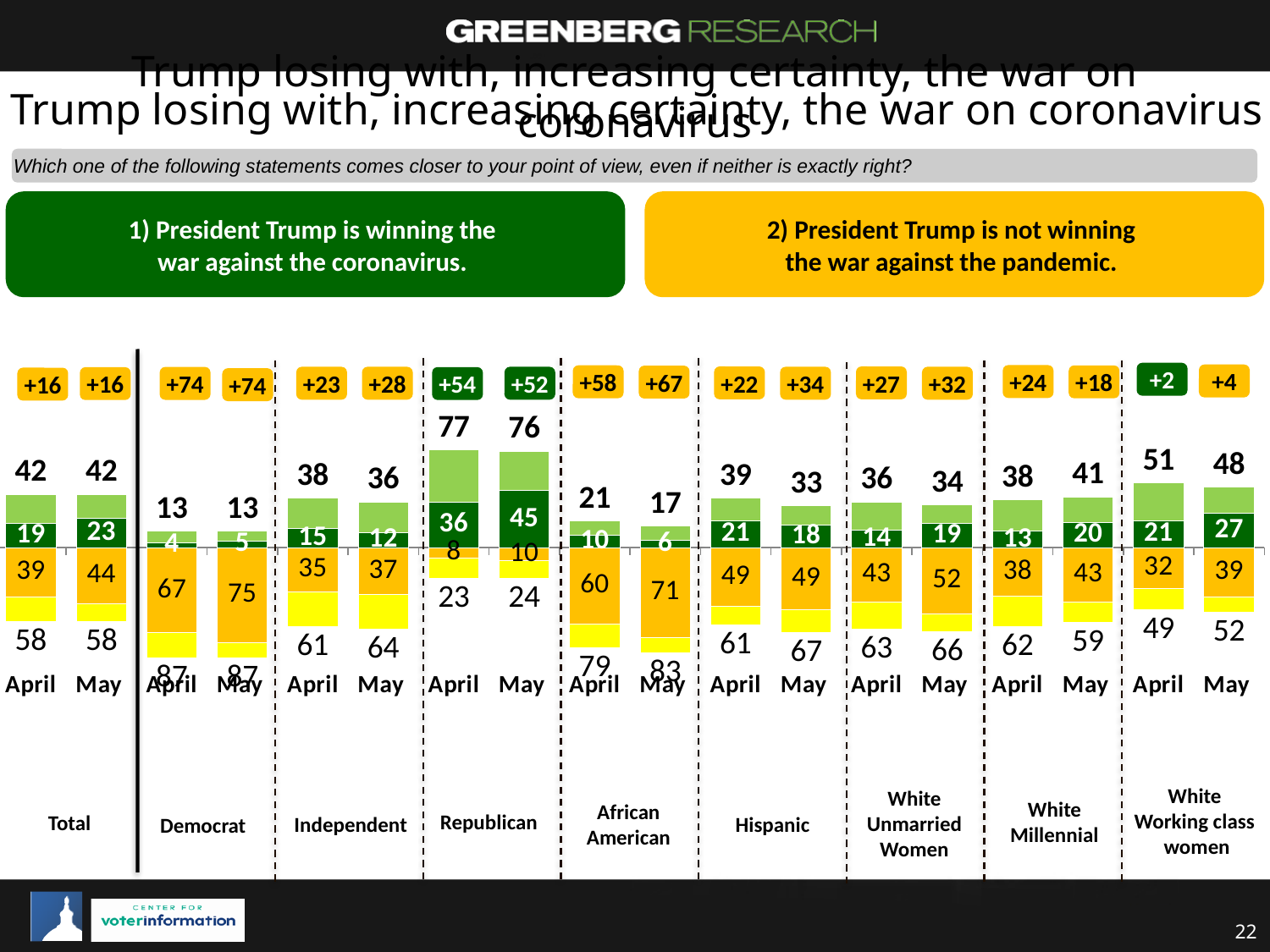
By how much did the total share saying Trump is winning fall from April to May among Hispanic respondents? 6 For White Millennials, is the total share saying Trump is winning higher in April or in May? May How many demographic groups are shown along the bottom of the chart? 9 Which group has the highest total share saying Trump is winning the war against the coronavirus in April? Republican What is the value of the dark green segment for Republicans in May? 45 What is the total share saying Trump is winning the war against the coronavirus among Republicans in April? 77 What kind of chart is shown on the slide? Stacked bar chart What is the total share saying Trump is winning the war against the coronavirus in May for the Total group? 42 What is the net margin shown above the April bar for White Working class women? +2 Which group has the lowest total share saying Trump is winning the war against the coronavirus in May? Democrat What is the total share saying Trump is not winning the war against the pandemic among Democrats in May? 87 What is the net margin shown above the May bar for African American respondents? +67